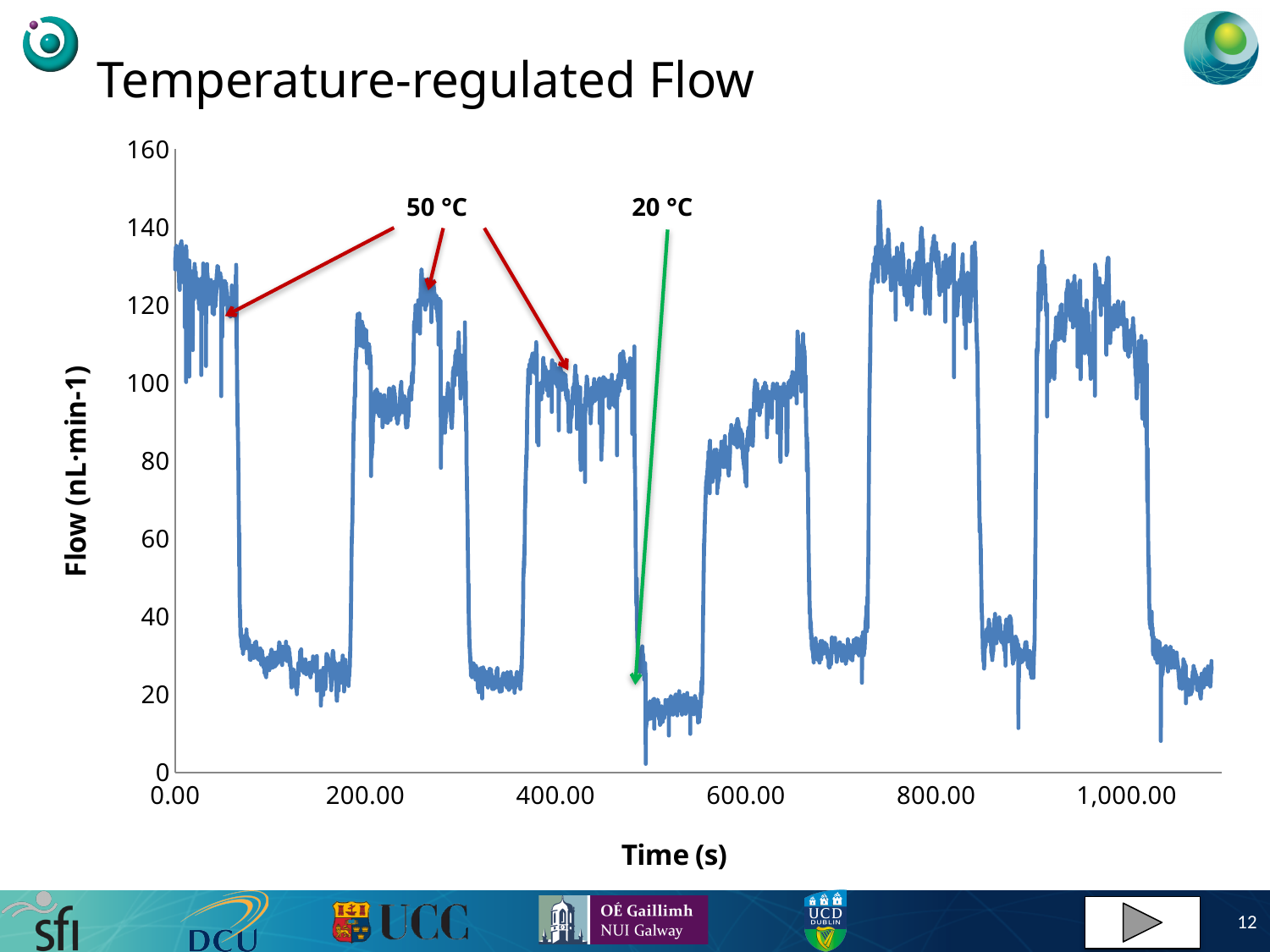
Does the flow rise or fall between about 60 s and 100 s? Falls How many data series are plotted on the chart? 1 Which two temperatures are annotated on the chart? 50 °C and 20 °C Is the flow value at around 100 s greater or less than 40? less Is the flow value at around 1,050 s greater or less than 60? less Is the flow value at around 950 s greater or less than 80? greater What is the highest tick value shown on the y-axis? 160 Which is larger: the flow at around 750 s or the flow at around 500 s? The flow at around 750 s What kind of chart is shown on the slide? Line chart What is the label of the y-axis? Flow (nL·min-1)